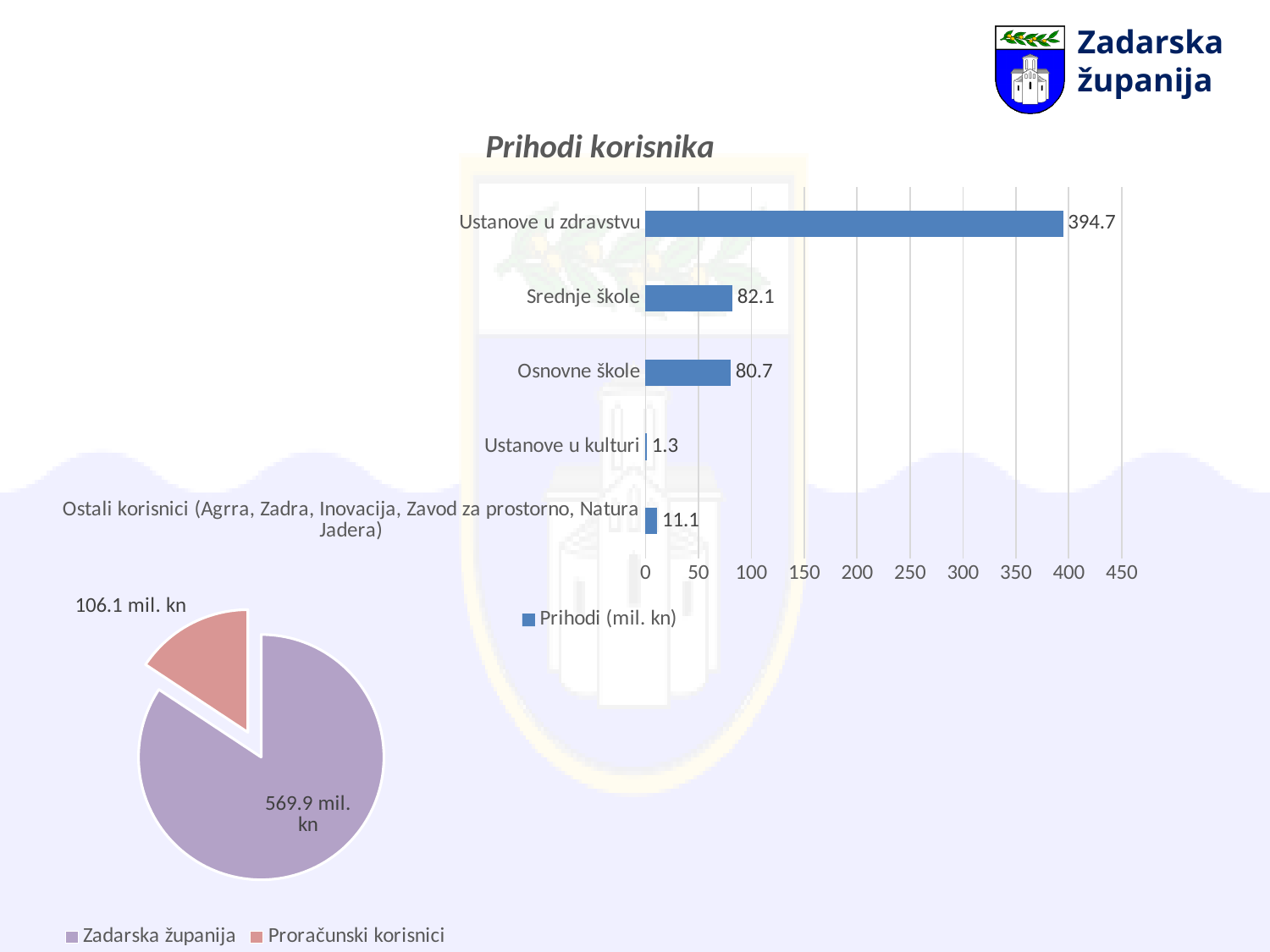
In the 'Prihodi korisnika' bar chart, how many categories are shown? 5 In the 'Prihodi korisnika' bar chart, which category has the highest value? Ustanove u zdravstvu In the 'Prihodi korisnika' bar chart, what is the value for Ustanove u kulturi? 1.3 In the pie chart at the bottom left, what is the value for Proračunski korisnici? 106.1 mil. kn In the 'Prihodi korisnika' bar chart, what is the difference between the values for Ustanove u zdravstvu and Srednje škole? 312.6 In the pie chart at the bottom left, which slice is larger: Zadarska županija or Proračunski korisnici? Zadarska županija In the 'Prihodi korisnika' bar chart, which is larger: the value for Srednje škole or the value for Ostali korisnici? Srednje škole What kind of chart is 'Prihodi korisnika'? Bar chart What series name does the legend of the 'Prihodi korisnika' bar chart show? Prihodi (mil. kn) In the 'Prihodi korisnika' bar chart, which category has the lowest value? Ustanove u kulturi In the 'Prihodi korisnika' bar chart, what is the value for Osnovne škole? 80.7 In the 'Prihodi korisnika' bar chart, what is the value for Ustanove u zdravstvu? 394.7